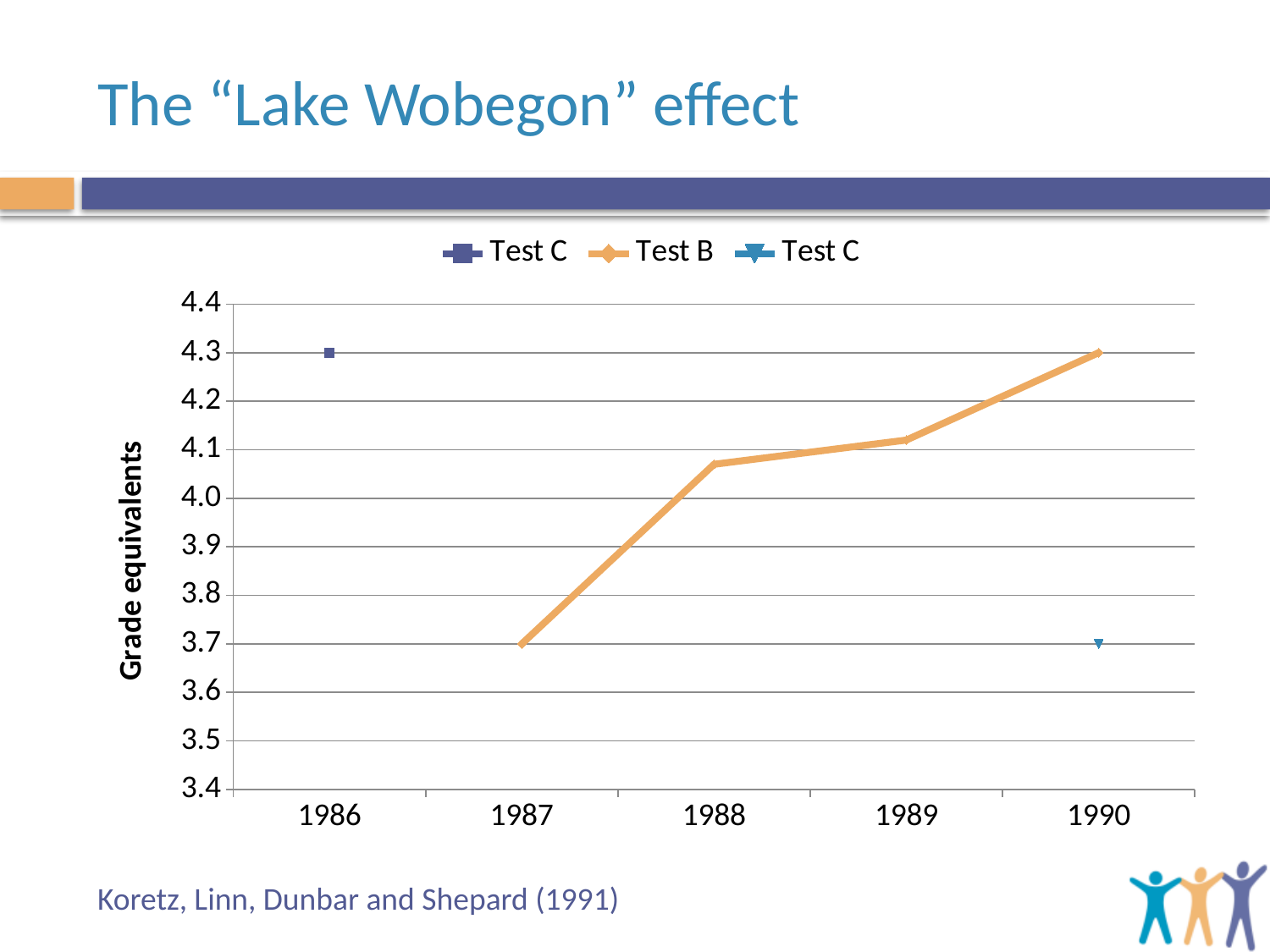
Is the value for Test B in 1988 greater or less than 4.0? greater In which year is the Test B value highest? 1990 What kind of chart is shown on the slide? line chart Is the value for Test B in 1989 greater or less than 4.0? greater What is the label on the y axis? Grade equivalents What is the difference between the Test B value in 1990 and in 1987? 0.6 How many years are shown on the x axis? 5 How many series does the legend list? 3 Does the Test B line rise or fall from 1987 to 1990? rise In which year is the Test B value lowest? 1987 What is the value for Test B in 1987? 3.7 What is the value for Test B in 1990? 4.3